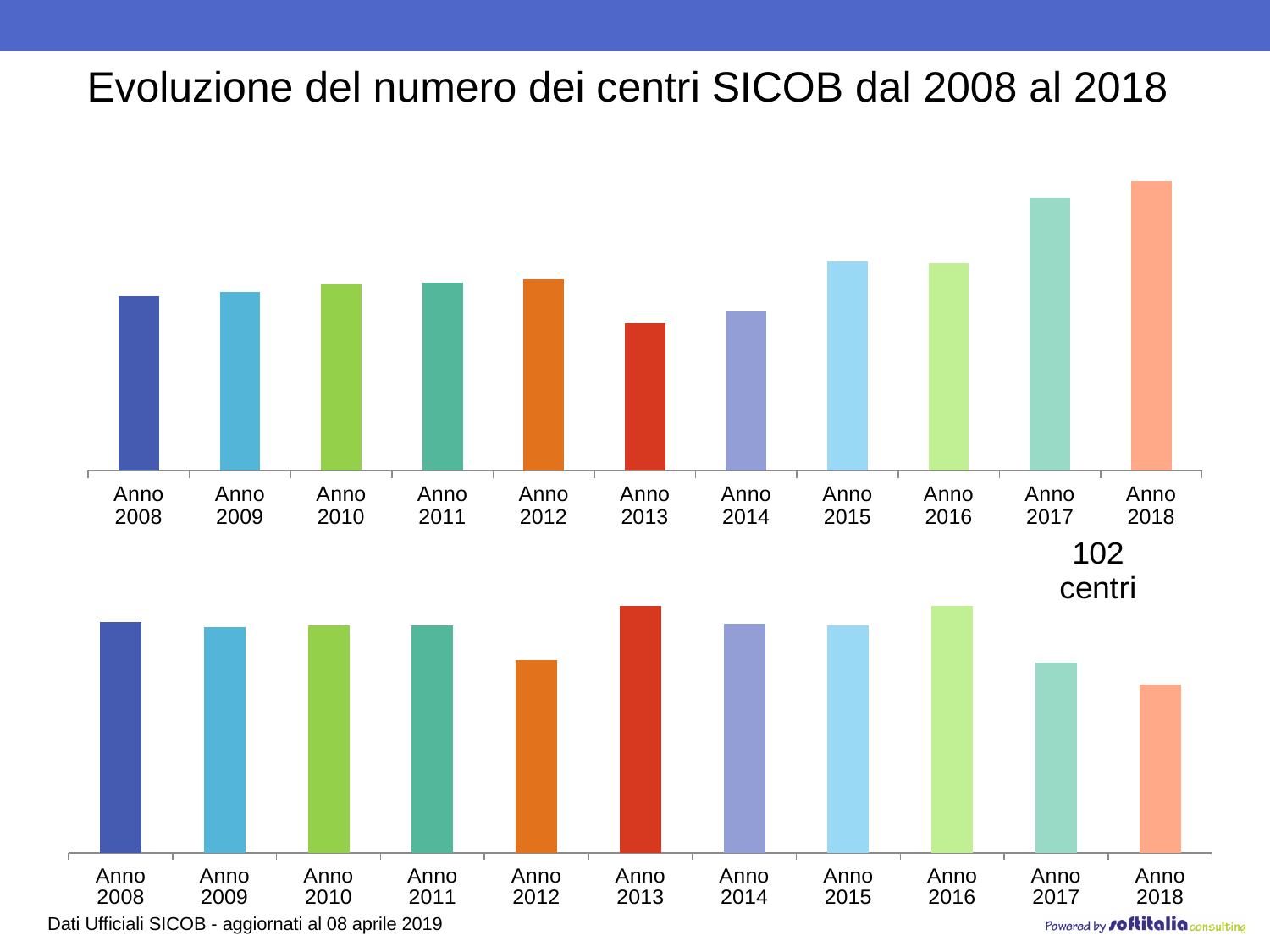
In the top chart, which year has the lowest bar? Anno 2013 In the top chart, do the bars generally rise or fall from Anno 2015 to Anno 2018? rise In the bottom chart, which year has the lowest bar? Anno 2018 In the top chart, which is larger, the bar for Anno 2014 or the bar for Anno 2015? Anno 2015 In the bottom chart, how many years (categories) are plotted? 11 In the top chart, which year has the highest bar? Anno 2018 In the top chart, how many years (categories) are plotted? 11 In the bottom chart, do the bars rise or fall from Anno 2016 to Anno 2018? fall What is the title of the slide containing the two charts? Evoluzione del numero dei centri SICOB dal 2008 al 2018 What kind of chart is the top chart on the slide? bar chart In the bottom chart, which is larger, the bar for Anno 2012 or the bar for Anno 2013? Anno 2013 What kind of chart is the bottom chart on the slide? bar chart